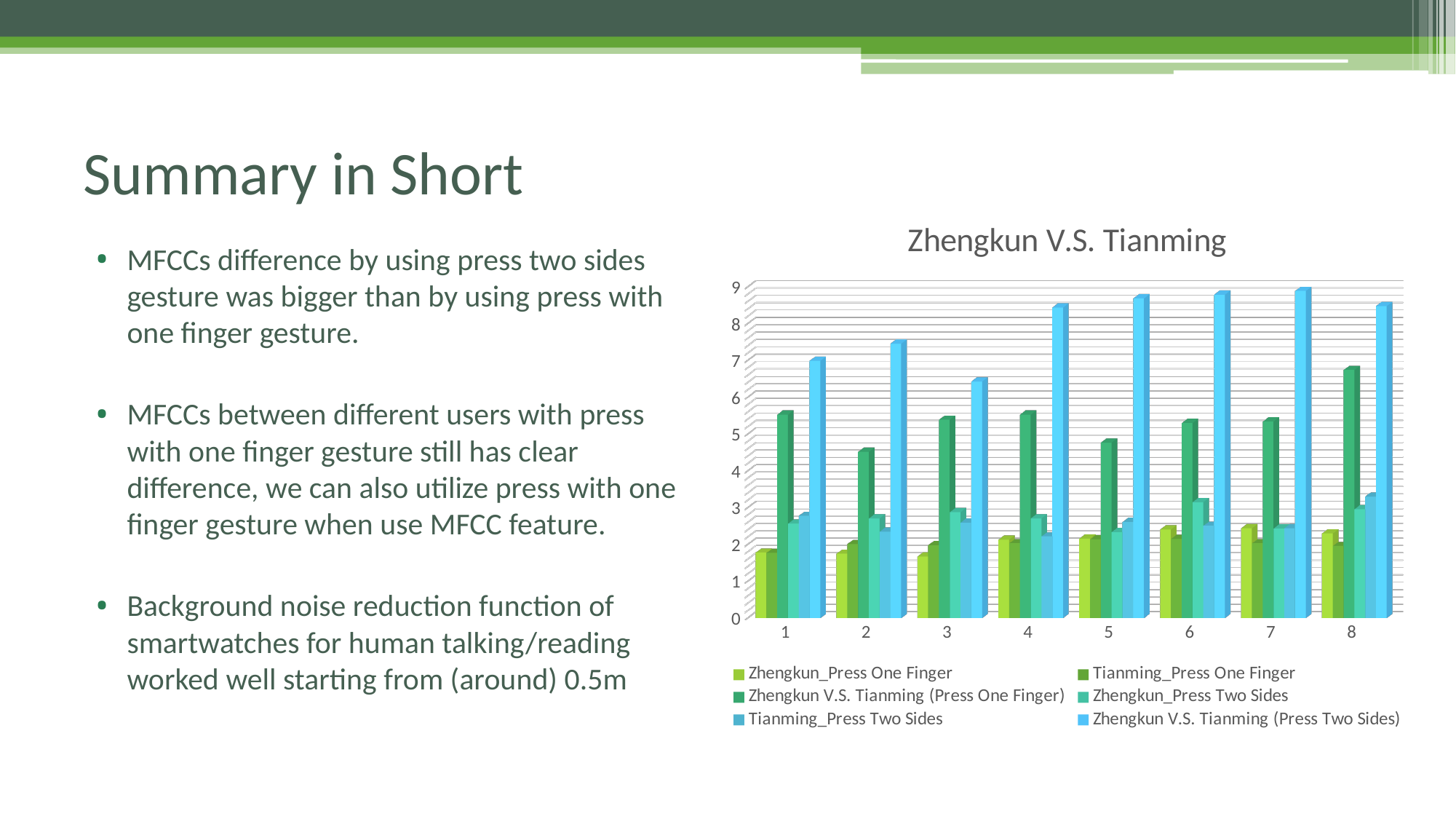
In category 8, which is larger: Tianming_Press One Finger or Zhengkun V.S. Tianming (Press Two Sides)? Zhengkun V.S. Tianming (Press Two Sides) Is the Tianming_Press One Finger value for category 2 greater or less than 5? less Which series has the tallest bar in every category of the chart? Zhengkun V.S. Tianming (Press Two Sides) In which category is the Zhengkun V.S. Tianming (Press Two Sides) value lowest? 3 Is the Zhengkun V.S. Tianming (Press Two Sides) value for category 1 greater or less than 6? greater How many series does the chart's legend list? 6 What kind of chart is shown on the slide? bar chart Does the Zhengkun V.S. Tianming (Press Two Sides) value rise or fall from category 3 to category 7? rise What is the title of the chart on the slide? Zhengkun V.S. Tianming Is the Zhengkun V.S. Tianming (Press Two Sides) value for category 3 greater or less than 6? greater How many categories are shown on the x axis of the chart? 8